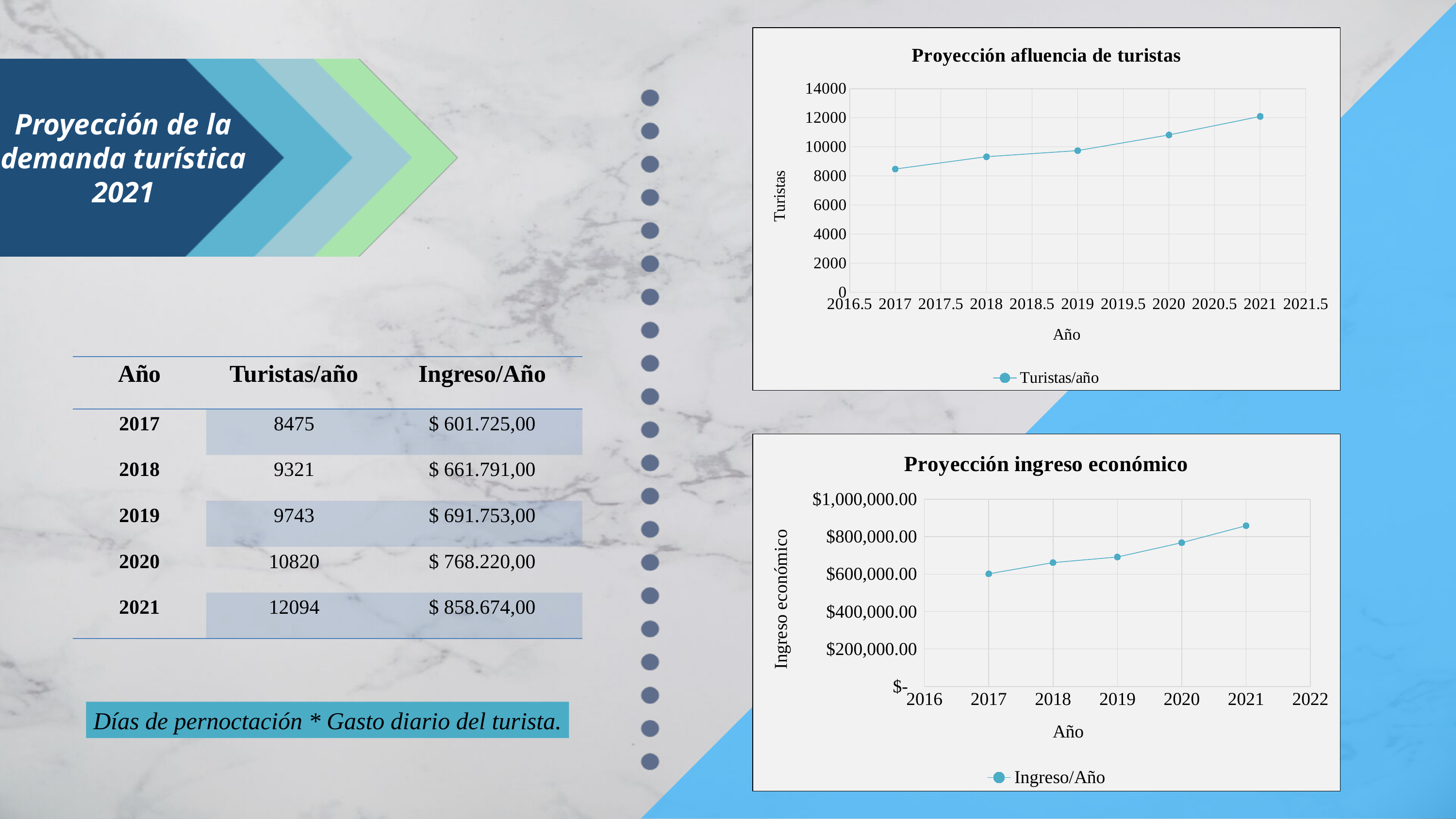
In the 'Proyección afluencia de turistas' chart, is the value for 2017 greater or less than 10000? less In the 'Proyección afluencia de turistas' chart, is the value for 2020 greater or less than 10000? greater In the 'Proyección afluencia de turistas' chart, what kind of chart is used to show the data? Line chart In the 'Proyección ingreso económico' chart, is the value for 2019 greater or less than $800,000.00? less In the 'Proyección ingreso económico' chart, which is larger, the value for 2018 or the value for 2020? 2020 In the 'Proyección afluencia de turistas' chart, do the values rise or fall from 2017 to 2021? Rise In the 'Proyección afluencia de turistas' chart, which year has the lowest number of tourists? 2017 In the 'Proyección afluencia de turistas' chart, which year has the highest number of tourists? 2021 In the 'Proyección ingreso económico' chart, how many series does the legend list? 1 In the 'Proyección afluencia de turistas' chart, how many data points are plotted? 5 In the 'Proyección afluencia de turistas' chart, what is the name of the series shown in the legend? Turistas/año